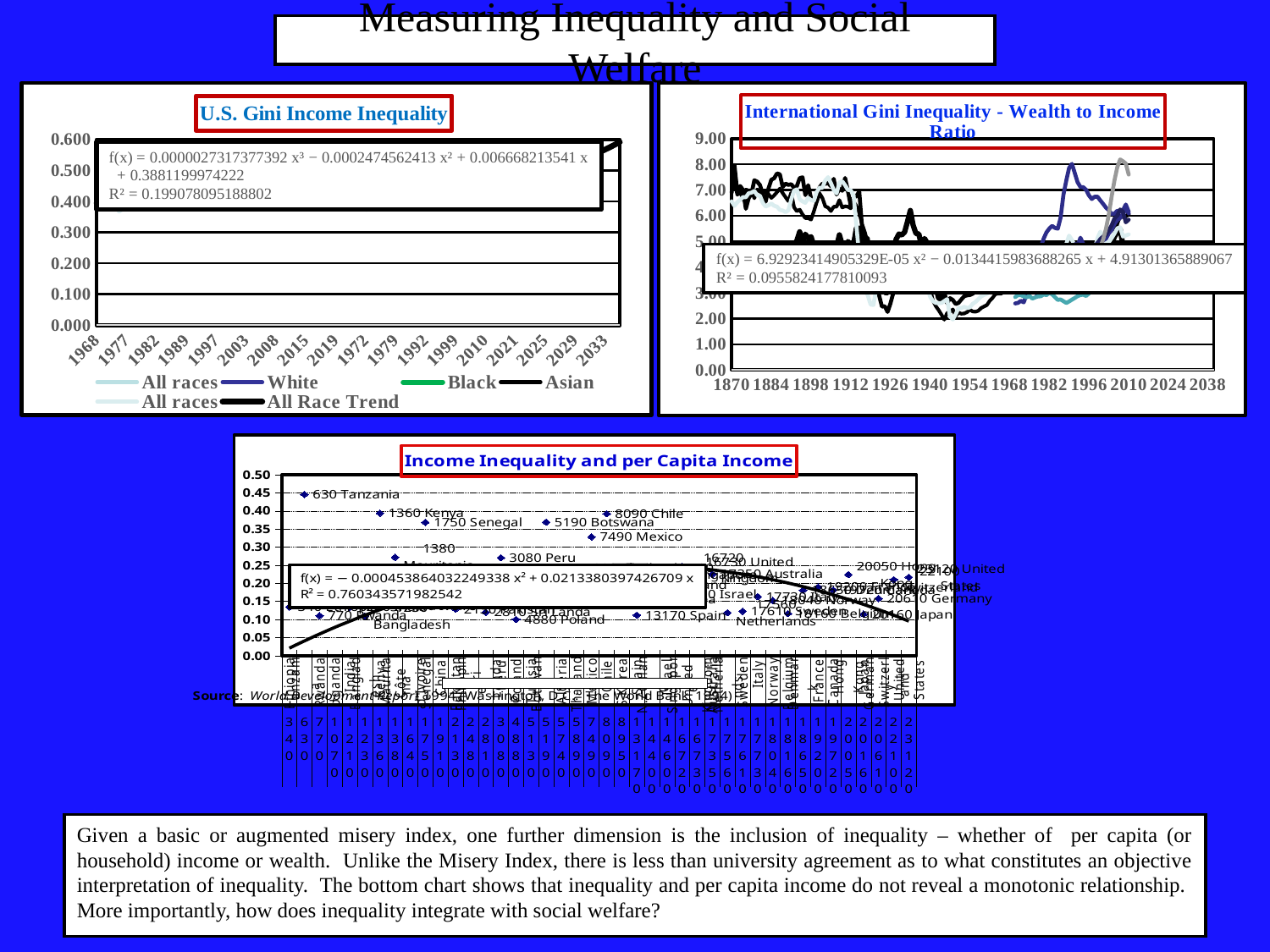
In the 'Income Inequality and per Capita Income' chart, is the value for Tanzania greater or less than 0.40? greater What kind of chart is the 'U.S. Gini Income Inequality' chart? Line chart What R² value is printed on the 'Income Inequality and per Capita Income' chart? 0.760343571982542 In the 'Income Inequality and per Capita Income' chart, which has the higher inequality value, Chile or Spain? Chile How many series does the legend of the 'U.S. Gini Income Inequality' chart list? 6 What kind of chart is the 'Income Inequality and per Capita Income' chart? Scatter chart In the 'Income Inequality and per Capita Income' chart, is the value for Spain greater or less than 0.20? less In the 'Income Inequality and per Capita Income' chart, which has the higher inequality value, Tanzania or Poland? Tanzania In the 'Income Inequality and per Capita Income' chart, is the value for Poland greater or less than 0.20? less What is the title of the chart in the top-right of the slide? International Gini Inequality - Wealth to Income Ratio In the 'Income Inequality and per Capita Income' chart, which labelled country has the highest inequality value? Tanzania